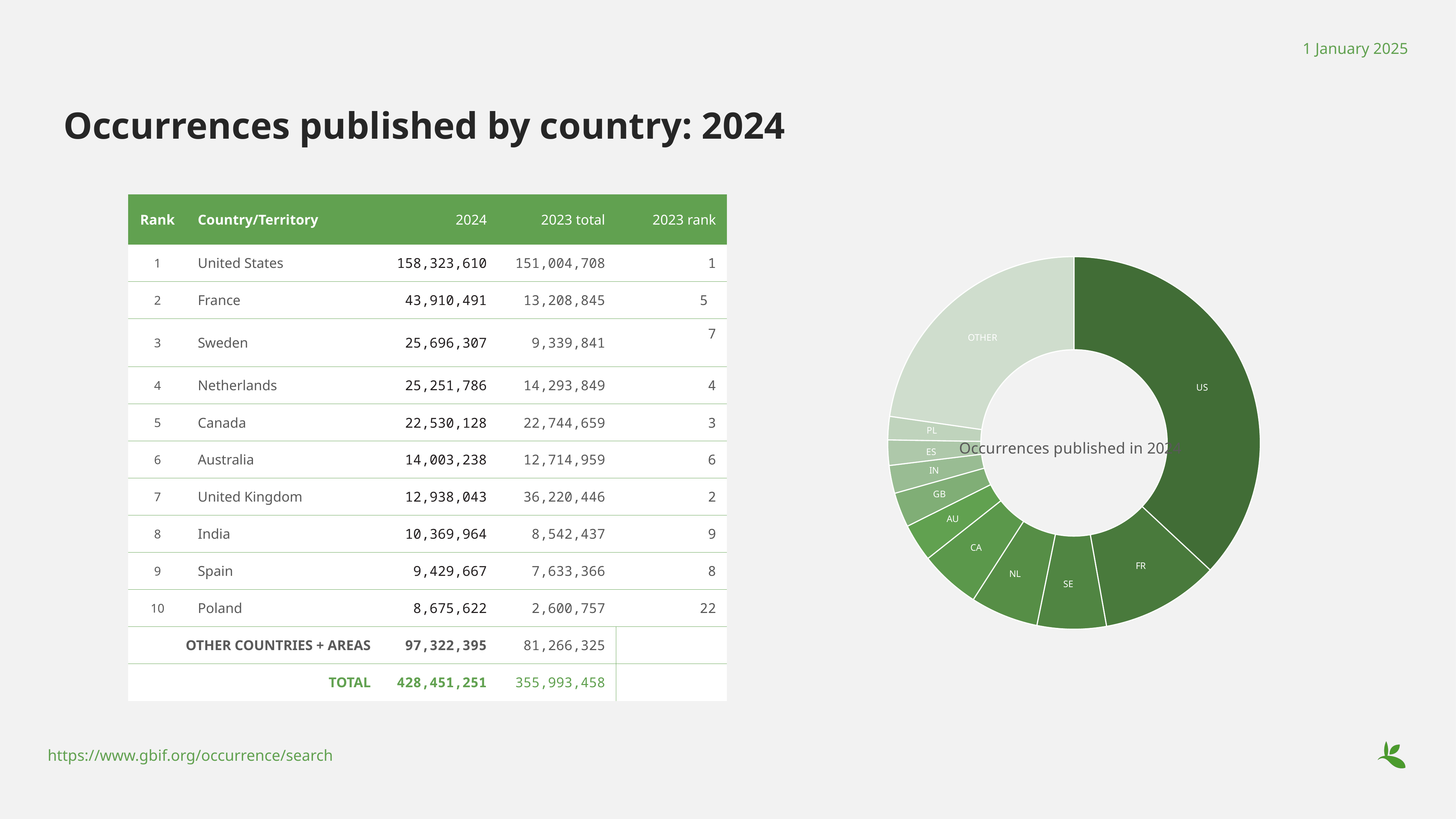
What kind of chart is shown on the right of the slide? donut chart In the donut chart, which segment is larger, OTHER or FR? OTHER What is the difference between the 2024 values for the US and FR segments? 114,413,119 Which segment of the donut chart is the largest? US What is the 2024 value for the US segment of the donut chart? 158,323,610 Which segment of the donut chart is shaded the lightest green? OTHER What is the 2024 value for the PL segment of the donut chart? 8,675,622 What text is written in the centre of the donut chart? Occurrences published in 2024 How many segments does the donut chart have? 11 In the donut chart, which segment is larger, CA or AU? CA In the donut chart, which segment is larger, US or FR? US Which country segment of the donut chart is the smallest? PL